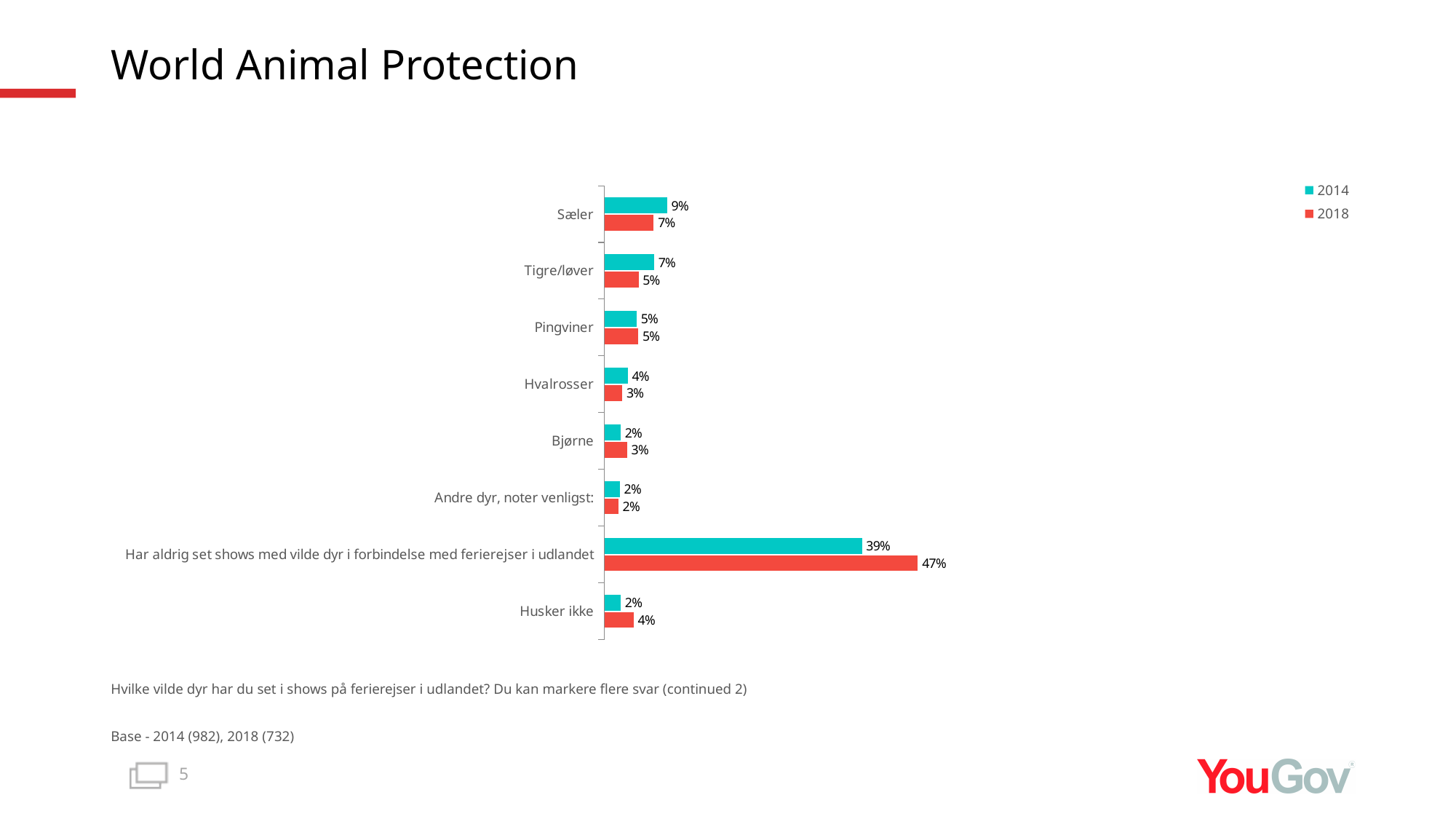
Which category has the highest 2018 value? Har aldrig set shows med vilde dyr i forbindelse med ferierejser i udlandet What kind of chart is shown on the slide? Bar chart How many categories are shown on the chart? 8 Which is larger for Bjørne, the 2014 value or the 2018 value? 2018 What is the difference between the 2014 and 2018 values for Sæler? 2% How many series does the legend list? 2 Which is larger for Hvalrosser, the 2014 value or the 2018 value? 2014 What is the 2018 value for Tigre/løver? 5% What is the 2018 value for Husker ikke? 4% Which category has the lowest 2018 value? Andre dyr, noter venligst: What is the difference between the 2018 and 2014 values for Har aldrig set shows med vilde dyr i forbindelse med ferierejser i udlandet? 8% What is the 2014 value for Sæler? 9%